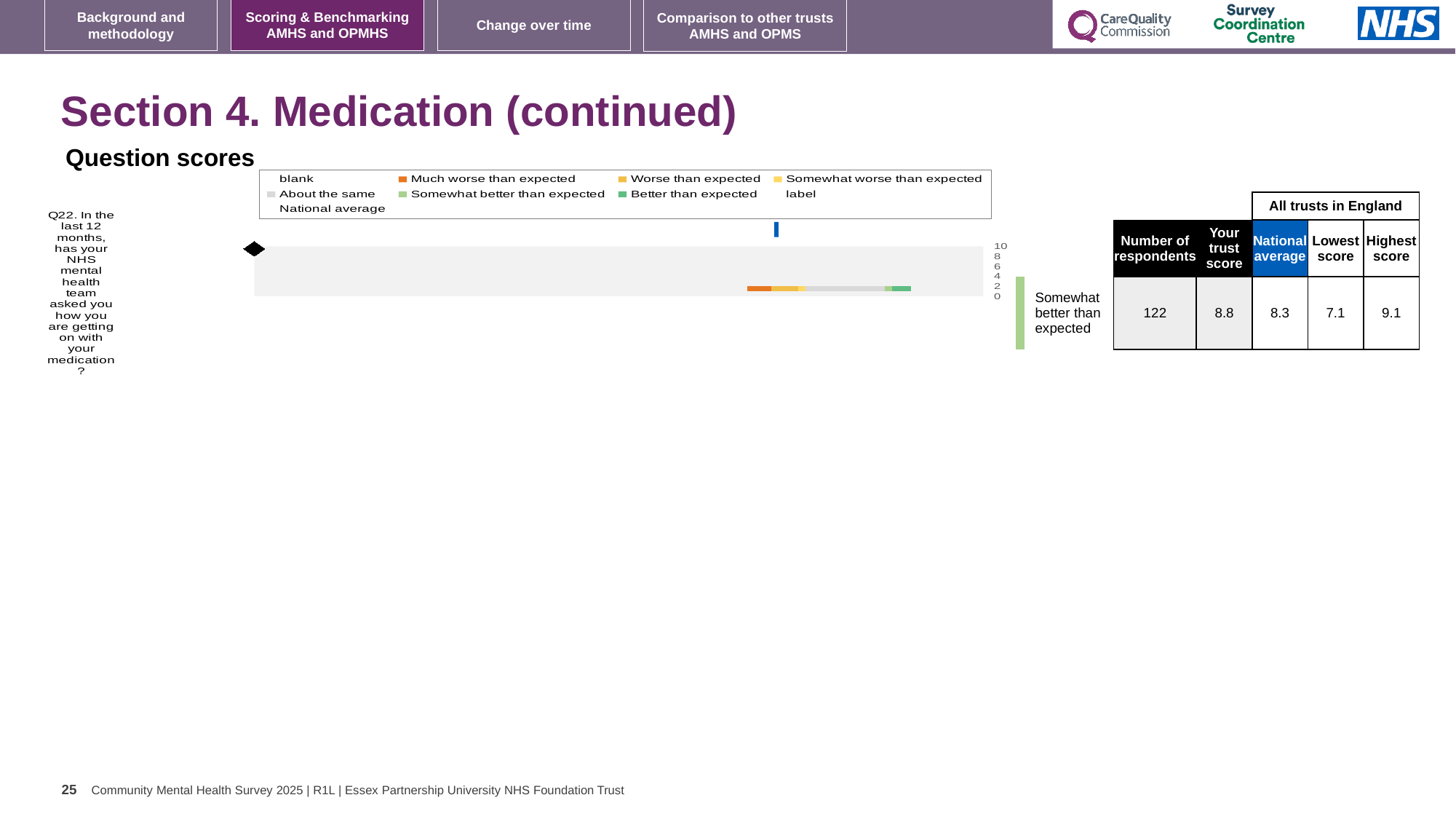
What kind of chart is shown on the slide for Q22? bar chart What colour represents 'Better than expected' in the chart legend? green What colour represents 'Much worse than expected' in the chart legend? orange In the table next to the chart, what is the national average score for Q22? 8.3 In the table next to the chart, what is the trust's score for Q22? 8.8 In the table next to the chart, what is the number of respondents for Q22? 122 What benchmark category is Q22 given on the slide? Somewhat better than expected Which is larger for Q22, the trust's score or the national average? the trust's score In the table next to the chart, what is the lowest score among all trusts in England for Q22? 7.1 In the table next to the chart, what is the highest score among all trusts in England for Q22? 9.1 How many entries does the chart legend list? 9 How many survey questions are plotted in the chart? 1